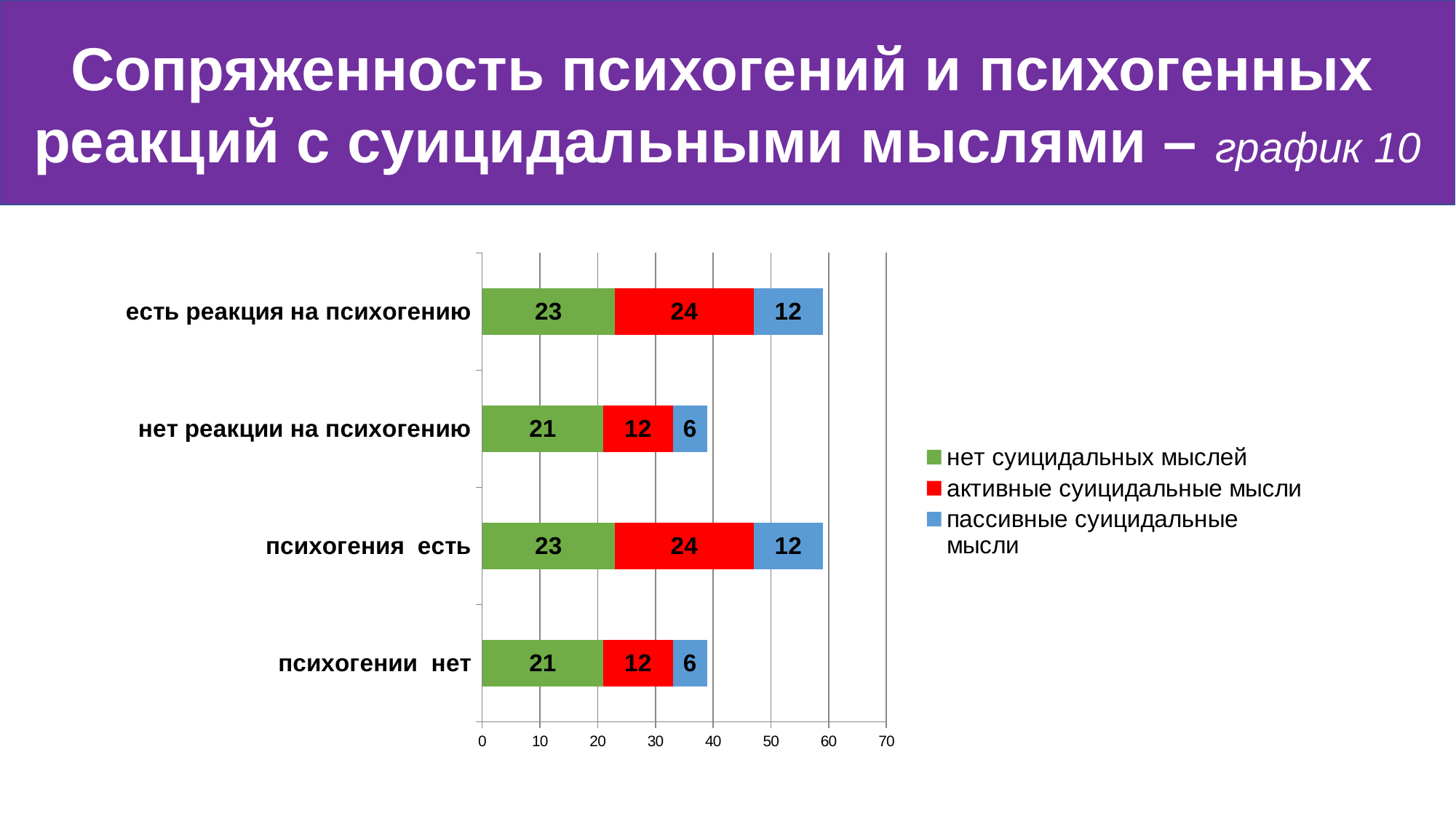
What is the total of the stacked bar for 'психогении нет'? 39 How many series does the legend list? 3 How many categories are shown on the chart? 4 What is the value for 'нет суицидальных мыслей' in the 'психогении нет' category? 21 What is the value for 'пассивные суицидальные мысли' in the 'нет реакции на психогению' category? 6 Which series has the lowest value in the 'нет реакции на психогению' category? пассивные суицидальные мысли Which is larger: the 'пассивные суицидальные мысли' value for 'есть реакция на психогению' or for 'нет реакции на психогению'? есть реакция на психогению What is the difference between the 'активные суицидальные мысли' values for 'психогения есть' and 'психогении нет'? 12 What kind of chart is shown on the slide? stacked bar chart Which series has the highest value in the 'психогения есть' category? активные суицидальные мысли What is the value for 'активные суицидальные мысли' in the 'есть реакция на психогению' category? 24 What is the total of the stacked bar for 'психогения есть'? 59